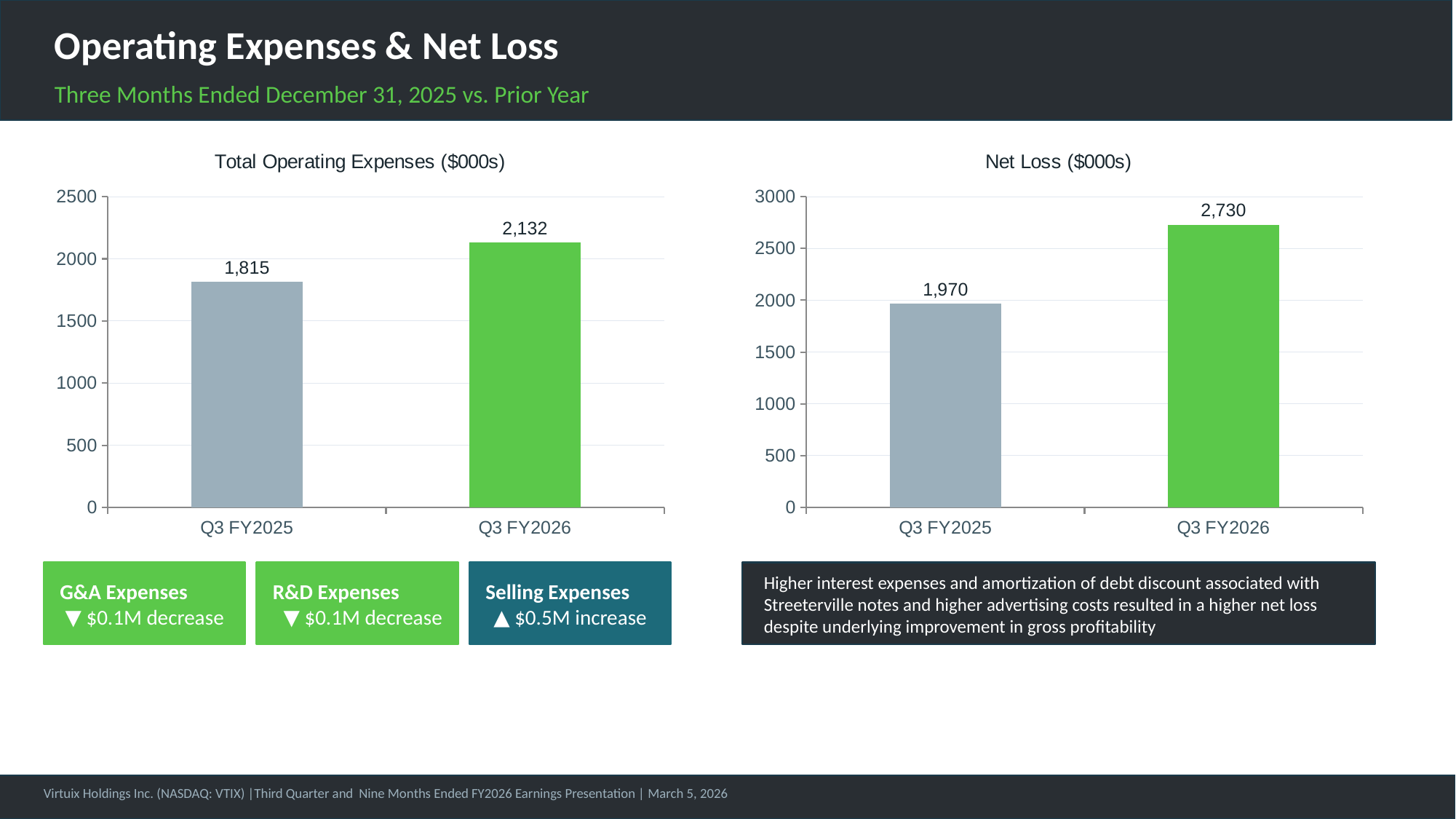
In the Net Loss ($000s) chart, do the values rise or fall from Q3 FY2025 to Q3 FY2026? Rise In the Total Operating Expenses ($000s) chart, what is the value for Q3 FY2026? 2,132 In the Net Loss ($000s) chart, what is the value for Q3 FY2025? 1,970 In the Net Loss ($000s) chart, is the value for Q3 FY2026 greater or less than 2500? greater In the Net Loss ($000s) chart, what is the value for Q3 FY2026? 2,730 In the Net Loss ($000s) chart, which quarter has the lower value? Q3 FY2025 In the Total Operating Expenses ($000s) chart, what is the difference between Q3 FY2026 and Q3 FY2025? 317 How many bars are shown in the Total Operating Expenses ($000s) chart? 2 In the Total Operating Expenses ($000s) chart, what is the value for Q3 FY2025? 1,815 In the Total Operating Expenses ($000s) chart, which quarter has the higher value? Q3 FY2026 In the Net Loss ($000s) chart, what is the difference between Q3 FY2026 and Q3 FY2025? 760 What kind of chart is the Net Loss ($000s) chart? Bar chart